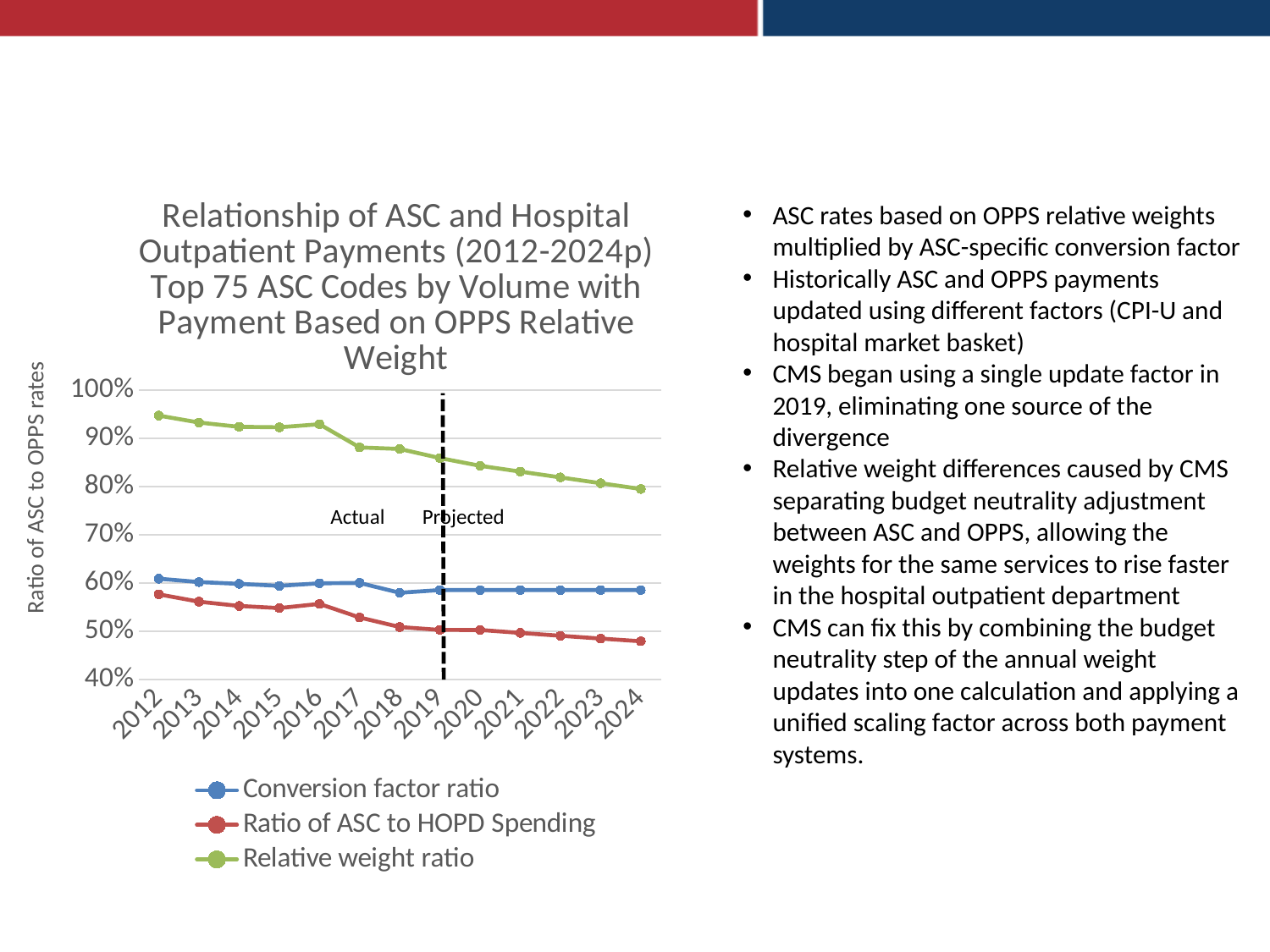
In which year is the Relative weight ratio lowest? 2024 Is the Relative weight ratio for 2012 greater or less than 90%? greater Does the Ratio of ASC to HOPD Spending series rise or fall from 2012 to 2024? Fall Is the Ratio of ASC to HOPD Spending for 2024 greater or less than 50%? less How many series does the chart's legend list? 3 What kind of chart is shown on the slide? Line chart In which year is the Relative weight ratio highest? 2012 How many years are plotted along the x axis of the chart? 13 Does the Relative weight ratio series rise or fall from 2012 to 2024? Fall Which series is higher in 2012, the Relative weight ratio or the Conversion factor ratio? Relative weight ratio What is the label on the vertical axis of the chart? Ratio of ASC to OPPS rates